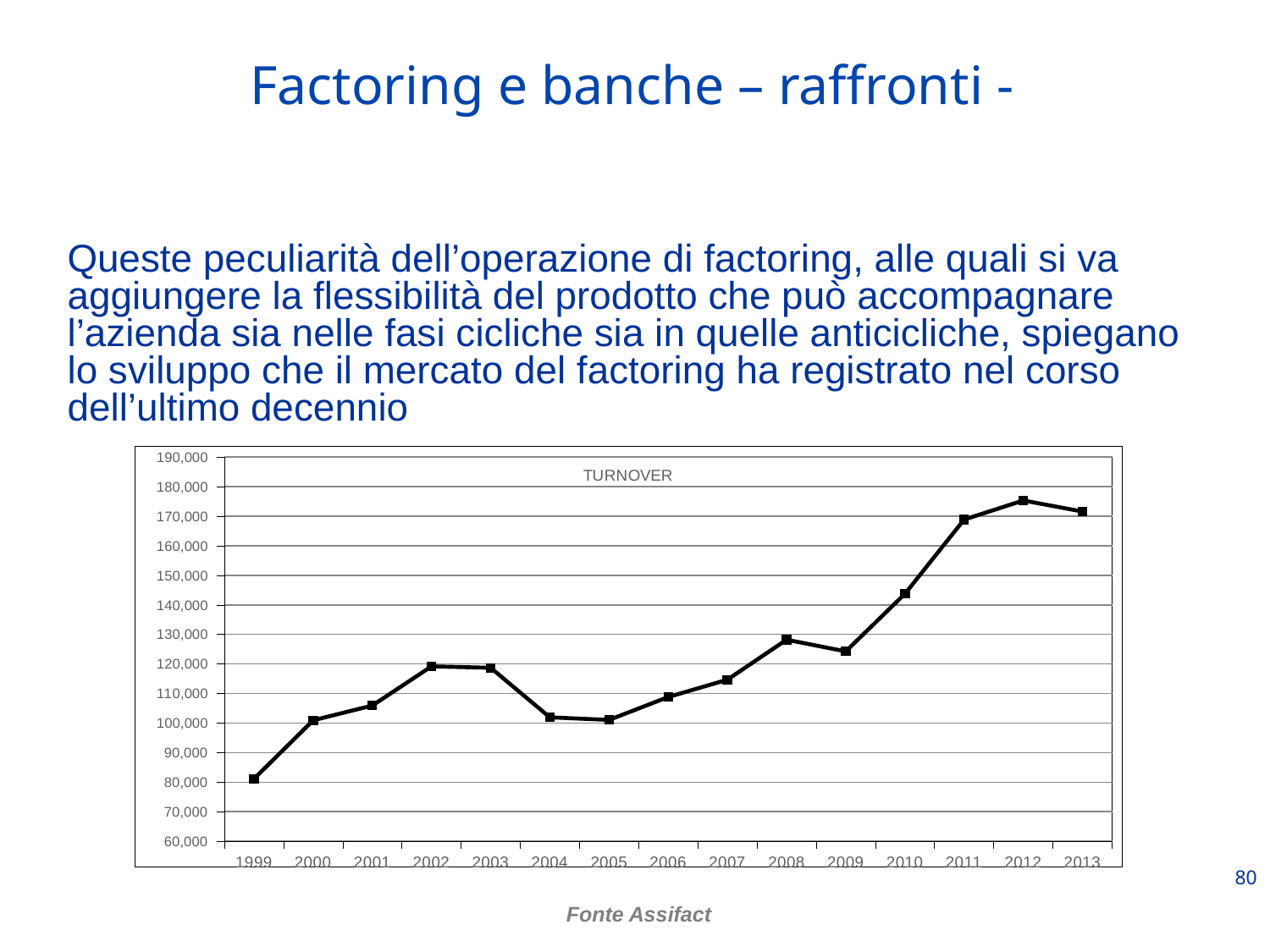
What source is cited below the chart? Fonte Assifact Is the value for 2010 greater or less than 140,000? greater Is the value for 1999 greater or less than 90,000? less Which year has the highest turnover value in the chart? 2012 Which year has the lowest turnover value in the chart? 1999 Is the value for 2011 greater or less than 160,000? greater What is the title shown inside the chart? TURNOVER What kind of chart is shown on the slide? line chart Which year has the larger value, 2010 or 2011? 2011 Do the values rise or fall from 1999 to 2002? rise How many years are plotted on the x axis of the chart? 15